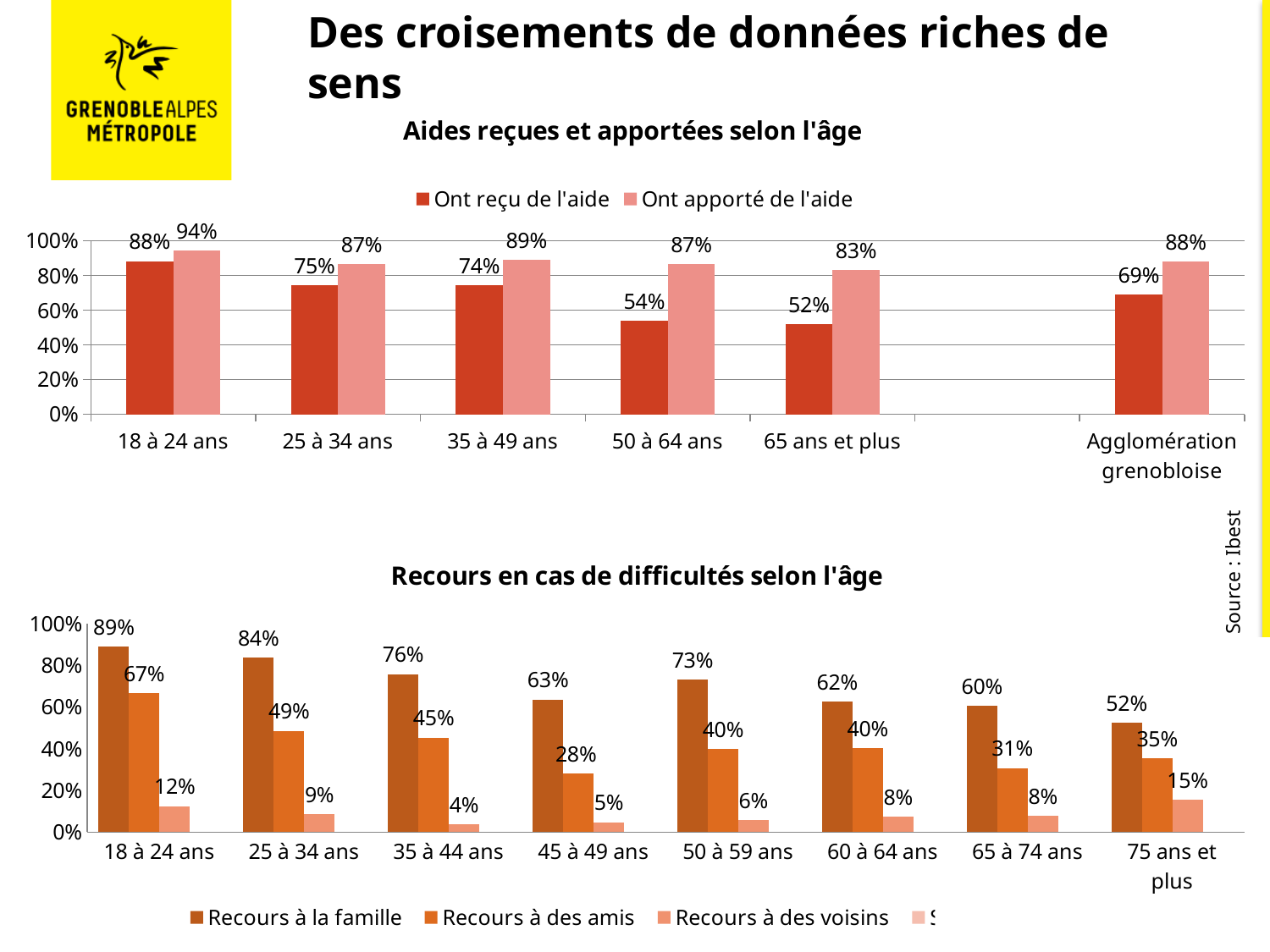
In the chart 'Recours en cas de difficultés selon l'âge', what is the value for 'Recours à des voisins' for 75 ans et plus? 15% In the chart 'Recours en cas de difficultés selon l'âge', which age group has the highest value for 'Recours à la famille'? 18 à 24 ans In the chart 'Aides reçues et apportées selon l'âge', what is the value for 'Ont apporté de l'aide' for 65 ans et plus? 83% In the chart 'Aides reçues et apportées selon l'âge', which age group has the lowest value for 'Ont reçu de l'aide'? 65 ans et plus In the chart 'Aides reçues et apportées selon l'âge', what is the difference between 'Ont apporté de l'aide' and 'Ont reçu de l'aide' for 50 à 64 ans? 33 percentage points In the chart 'Aides reçues et apportées selon l'âge', what is the value for 'Ont reçu de l'aide' for 18 à 24 ans? 88% In the chart 'Recours en cas de difficultés selon l'âge', how many age groups are shown on the x axis? 8 In the chart 'Aides reçues et apportées selon l'âge', how many series does the legend list? 2 In the chart 'Recours en cas de difficultés selon l'âge', what is the value for 'Recours à la famille' for 45 à 49 ans? 63% In the chart 'Recours en cas de difficultés selon l'âge', does 'Recours à la famille' generally rise or fall from 18 à 24 ans to 75 ans et plus? fall What kind of chart is 'Recours en cas de difficultés selon l'âge'? bar chart In the chart 'Aides reçues et apportées selon l'âge', what is the value for 'Ont reçu de l'aide' for Agglomération grenobloise? 69%